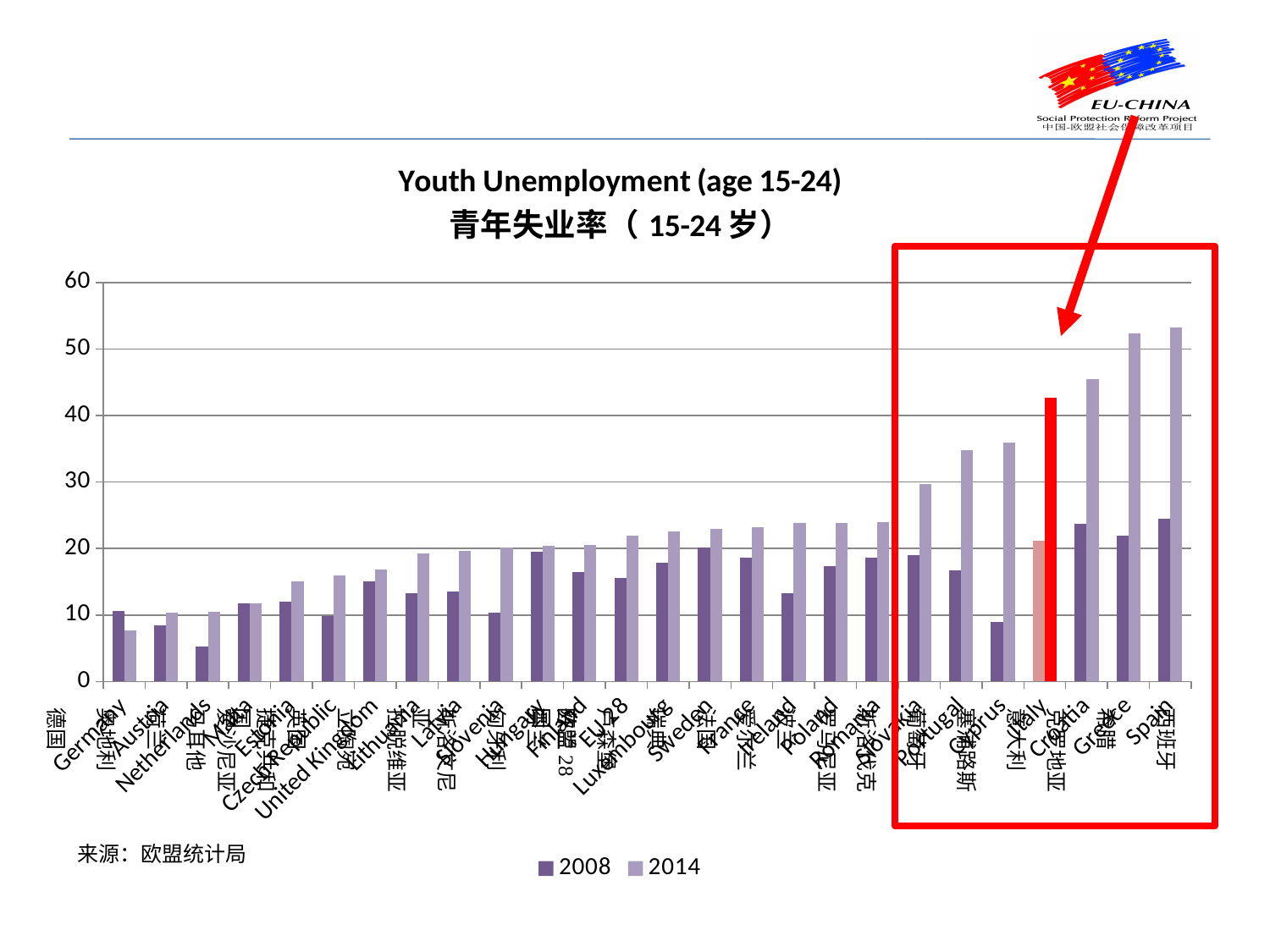
Is the 2014 value for Germany greater or less than 10? less Do the 2014 values generally rise or fall moving from left to right along the x axis? rise For Germany, which is larger: the 2008 value or the 2014 value? 2008 How many series does the legend list? 2 Is the 2014 value for Spain greater or less than 50? greater What kind of chart is shown on the slide? bar chart Is the 2014 value for Greece greater or less than 40? greater Which category has the highest 2014 value? Spain What is the English title of the chart? Youth Unemployment (age 15-24) Which category has the lowest 2008 value? Netherlands How many countries/categories are plotted along the x axis? 26 What are the two series named in the legend? 2008 and 2014